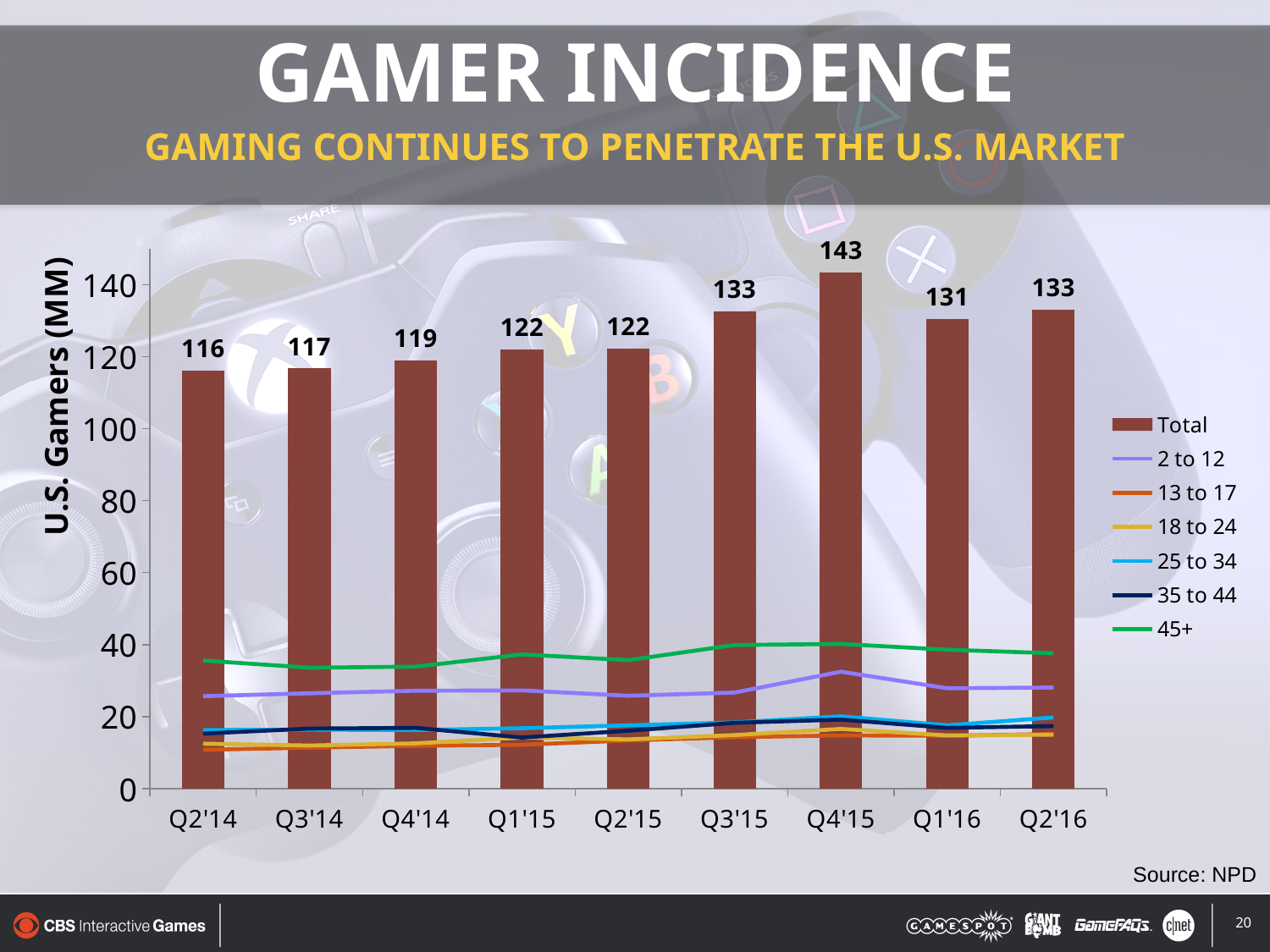
Does the Total value rise or fall from Q2'14 to Q4'15? rise How many quarters are shown on the x axis? 9 What is the Total value for Q1'16? 131 Which quarter has the lowest Total value? Q2'14 What is the Total value for Q2'14? 116 Which quarter has the highest Total value? Q4'15 Is the value for the 2 to 12 series at Q2'14 greater or less than 40? less How many series does the legend list? 7 What is the Total value for Q4'15? 143 Is the value for the 45+ series at Q4'15 greater or less than 20? greater What is the difference between the Total values for Q4'15 and Q1'16? 12 Which is larger, the Total value for Q3'15 or for Q1'16? Q3'15